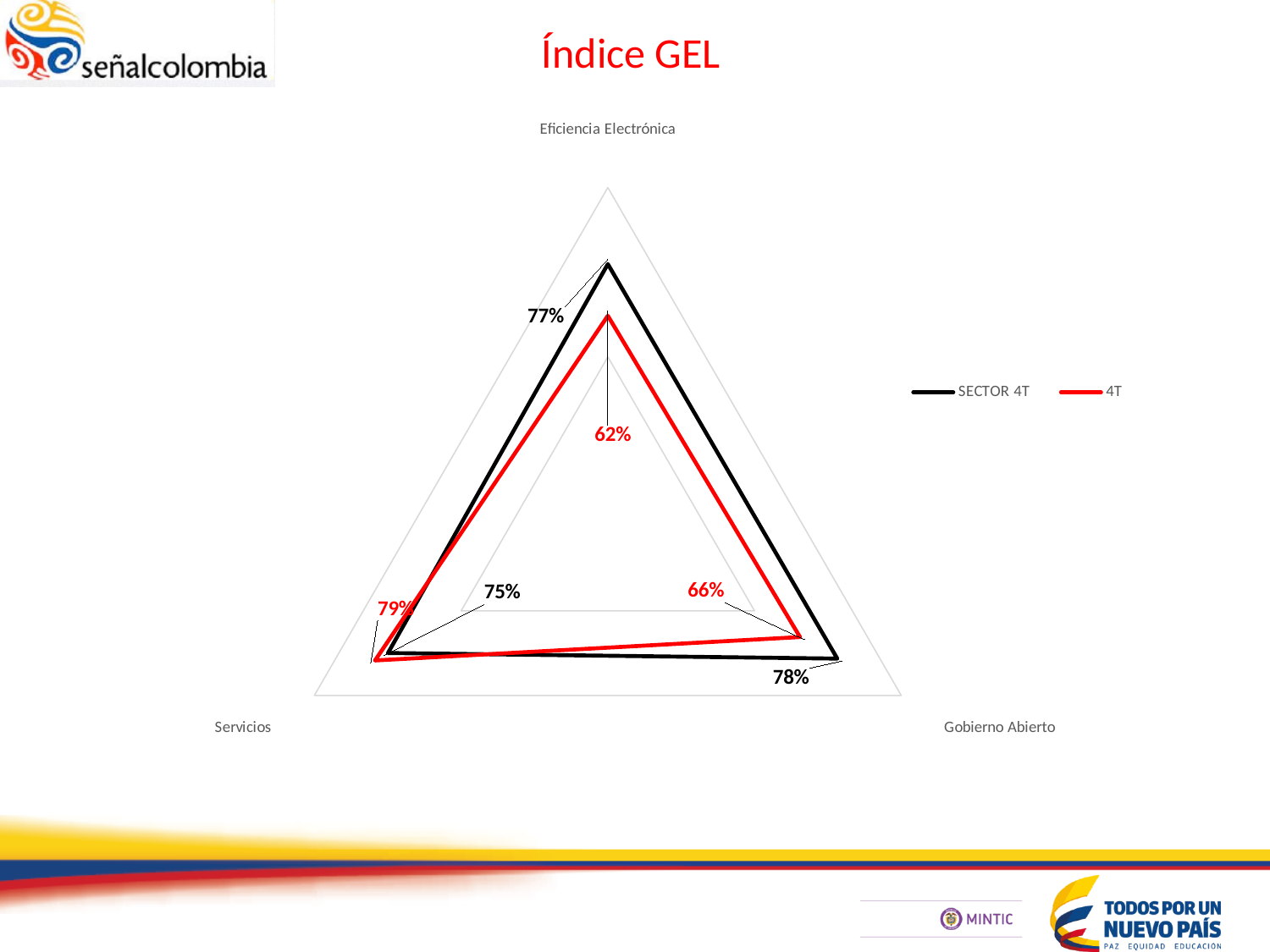
Which category has the highest value for the 4T series? Servicios How many categories (axes) does the radar chart have? 3 What is the value of 4T for Gobierno Abierto? 66% What is the value of SECTOR 4T for Gobierno Abierto? 78% How many series does the legend list? 2 What kind of chart is shown on the slide? Radar chart What is the value of SECTOR 4T for Eficiencia Electrónica? 77% For Servicios, which series has the larger value, SECTOR 4T or 4T? 4T Which category has the lowest value for the 4T series? Eficiencia Electrónica What is the difference between SECTOR 4T and 4T for Eficiencia Electrónica? 15% What is the value of 4T for Eficiencia Electrónica? 62% What is the value of 4T for Servicios? 79%